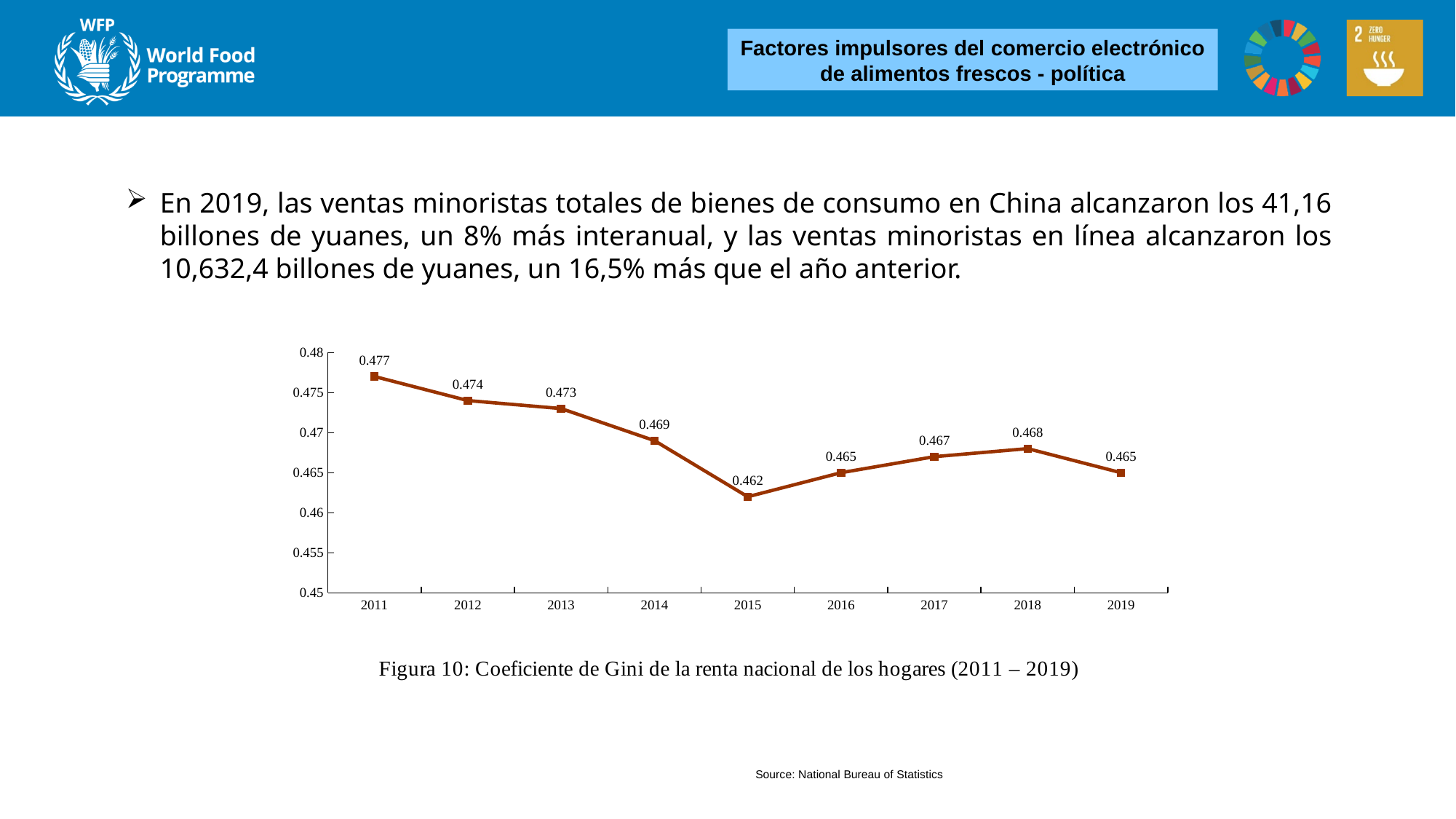
What is the Gini coefficient value for 2015? 0.462 Which year has the highest Gini coefficient? 2011 What is the difference between the Gini coefficient in 2011 and in 2015? 0.015 Which year has a higher Gini coefficient, 2014 or 2018? 2014 Is the value for 2013 greater or less than 0.47? greater What is the Gini coefficient value for 2011? 0.477 What is the caption of the figure shown on the slide? Figura 10: Coeficiente de Gini de la renta nacional de los hogares (2011 – 2019) What is the Gini coefficient value for 2019? 0.465 How many years are plotted on the chart? 9 Which year has the lowest Gini coefficient? 2015 Does the Gini coefficient rise or fall from 2011 to 2015? fall What kind of chart is shown on the slide? line chart